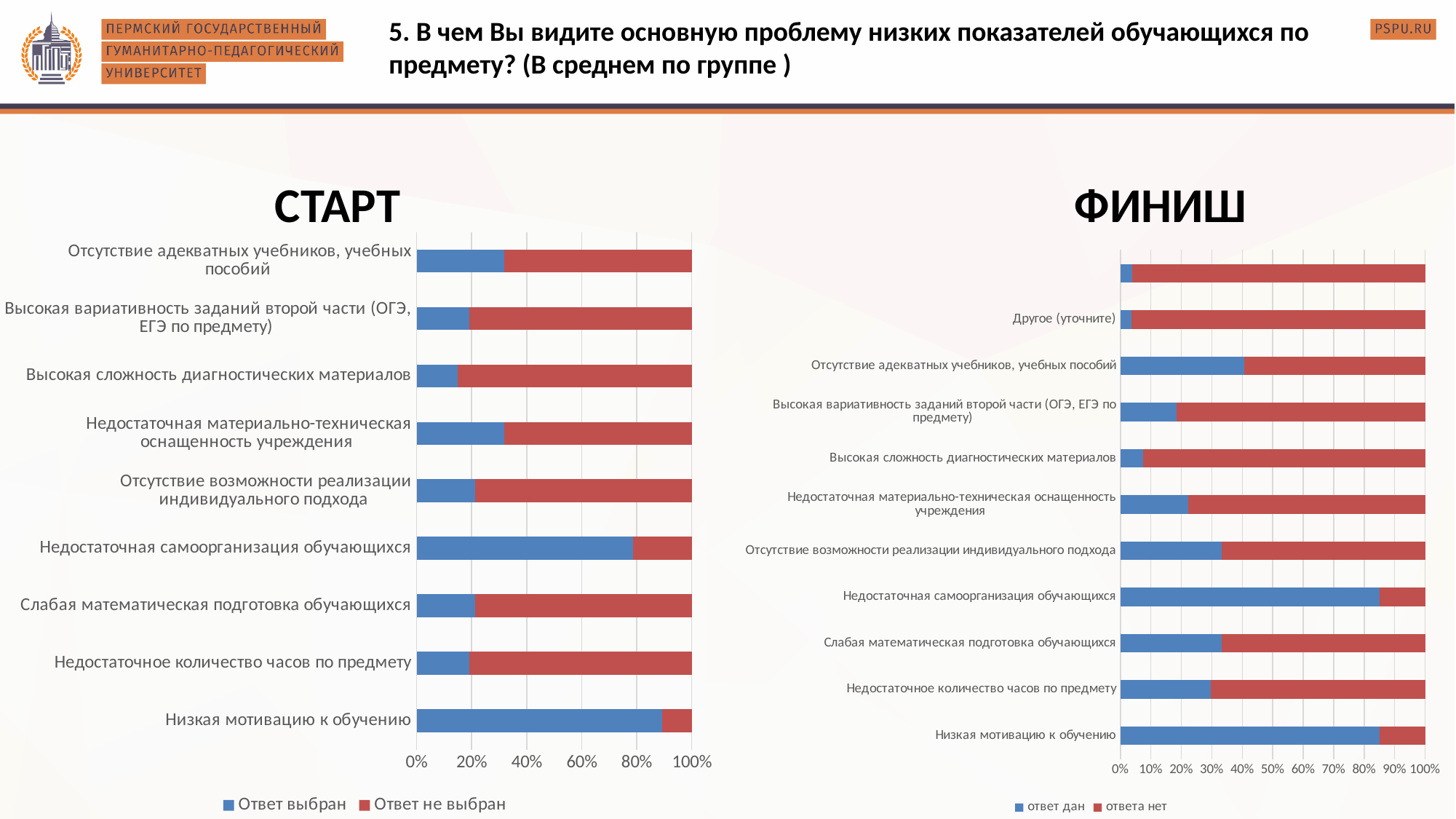
How many series does the legend of the СТАРТ chart list? 2 In the СТАРТ chart, which has a larger 'Ответ выбран' share: 'Низкая мотивацию к обучению' or 'Слабая математическая подготовка обучающихся'? Низкая мотивацию к обучению What are the two legend entries of the ФИНИШ chart on the right? ответ дан, ответа нет How many categories does the СТАРТ chart on the left show? 9 In the ФИНИШ chart, is the 'ответ дан' share for 'Недостаточная самоорганизация обучающихся' greater or less than 80%? greater In the СТАРТ chart, which category has the highest share of 'Ответ выбран'? Низкая мотивацию к обучению In the ФИНИШ chart, is the 'ответ дан' share for 'Высокая сложность диагностических материалов' greater or less than 10%? less In the СТАРТ chart, is the 'Ответ выбран' share for 'Недостаточная самоорганизация обучающихся' greater or less than 60%? greater What colour represents 'Ответ не выбран' in the СТАРТ chart? Red What kind of chart is the СТАРТ chart on the left? Stacked bar chart In the ФИНИШ chart, which has a larger 'ответ дан' share: 'Недостаточное количество часов по предмету' or 'Высокая сложность диагностических материалов'? Недостаточное количество часов по предмету